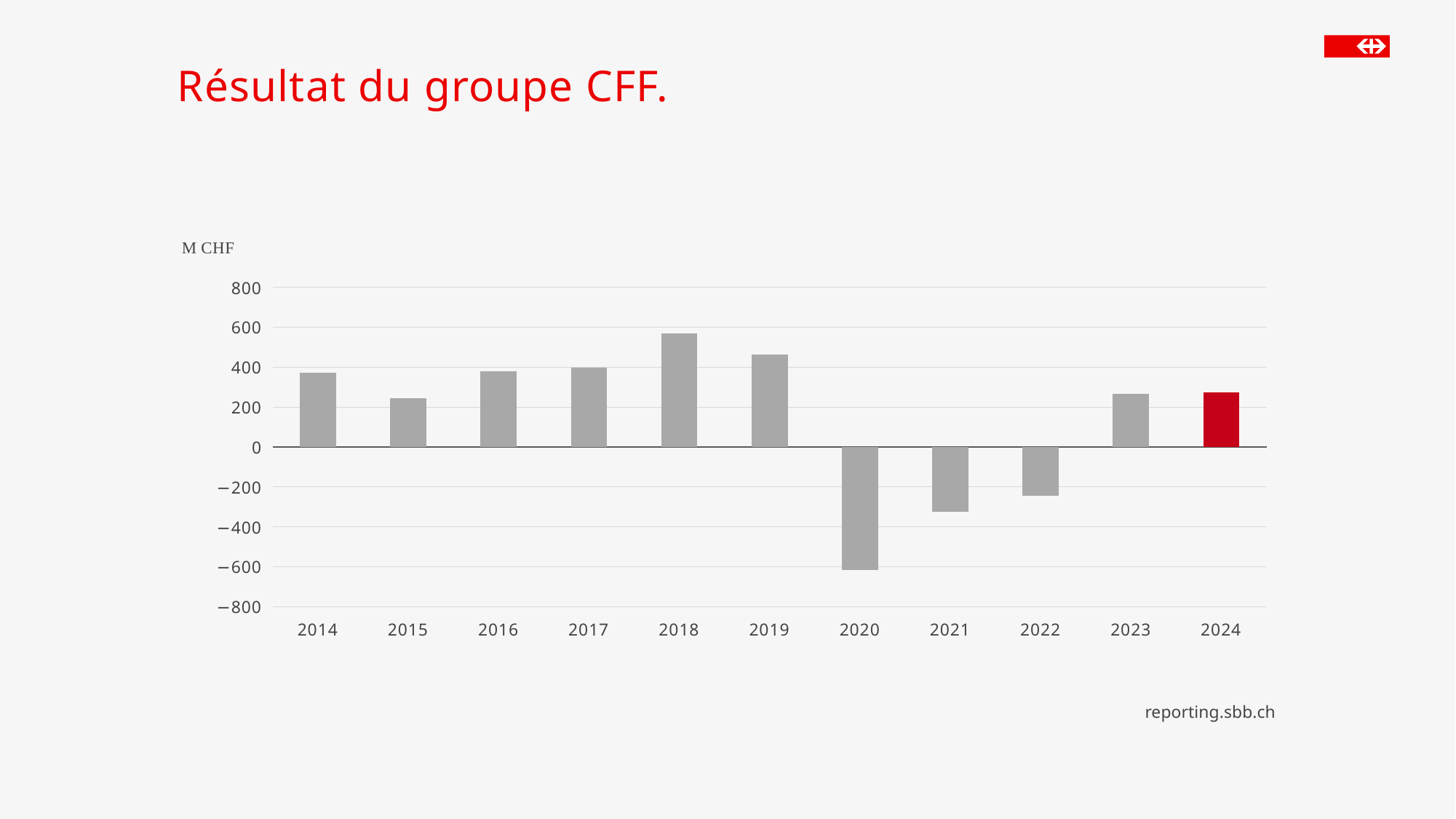
Which year has the highest value in the chart? 2018 Is the value for 2021 greater or less than -200? less How many years show a negative value in the chart? 3 Which year has the lowest value in the chart? 2020 How many years are shown on the x axis of the chart? 11 Do the values rise or fall from 2020 to 2024? rise Is the value for 2020 greater or less than -400? less Is the value for 2015 greater or less than 400? less What kind of chart is shown on the slide? bar chart What unit is shown above the y axis of the chart? M CHF Which year has the larger value, 2018 or 2019? 2018